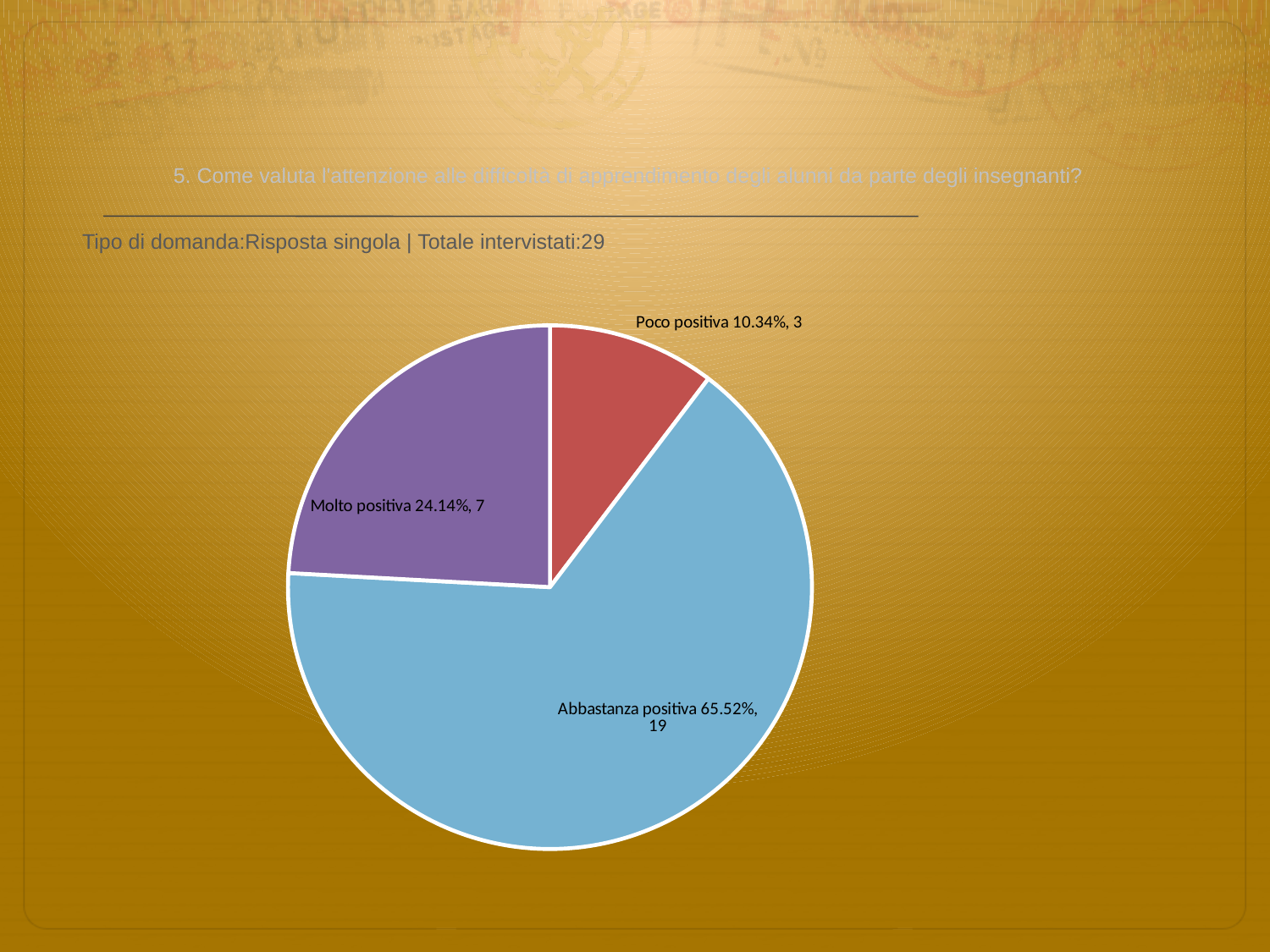
What is the total number of respondents across all slices? 29 Which has more respondents, 'Molto positiva' or 'Poco positiva'? Molto positiva What colour is the 'Molto positiva' slice? purple What kind of chart is shown on the slide? pie chart What percentage share does the 'Abbastanza positiva' slice have? 65.52% What percentage share does the 'Poco positiva' slice have? 10.34% How many respondents answered 'Poco positiva'? 3 Which category has the largest slice of the pie? Abbastanza positiva How many respondents answered 'Molto positiva'? 7 How many slices does the pie chart have? 3 What is the difference in number of respondents between 'Abbastanza positiva' and 'Molto positiva'? 12 Which category has the smallest slice of the pie? Poco positiva